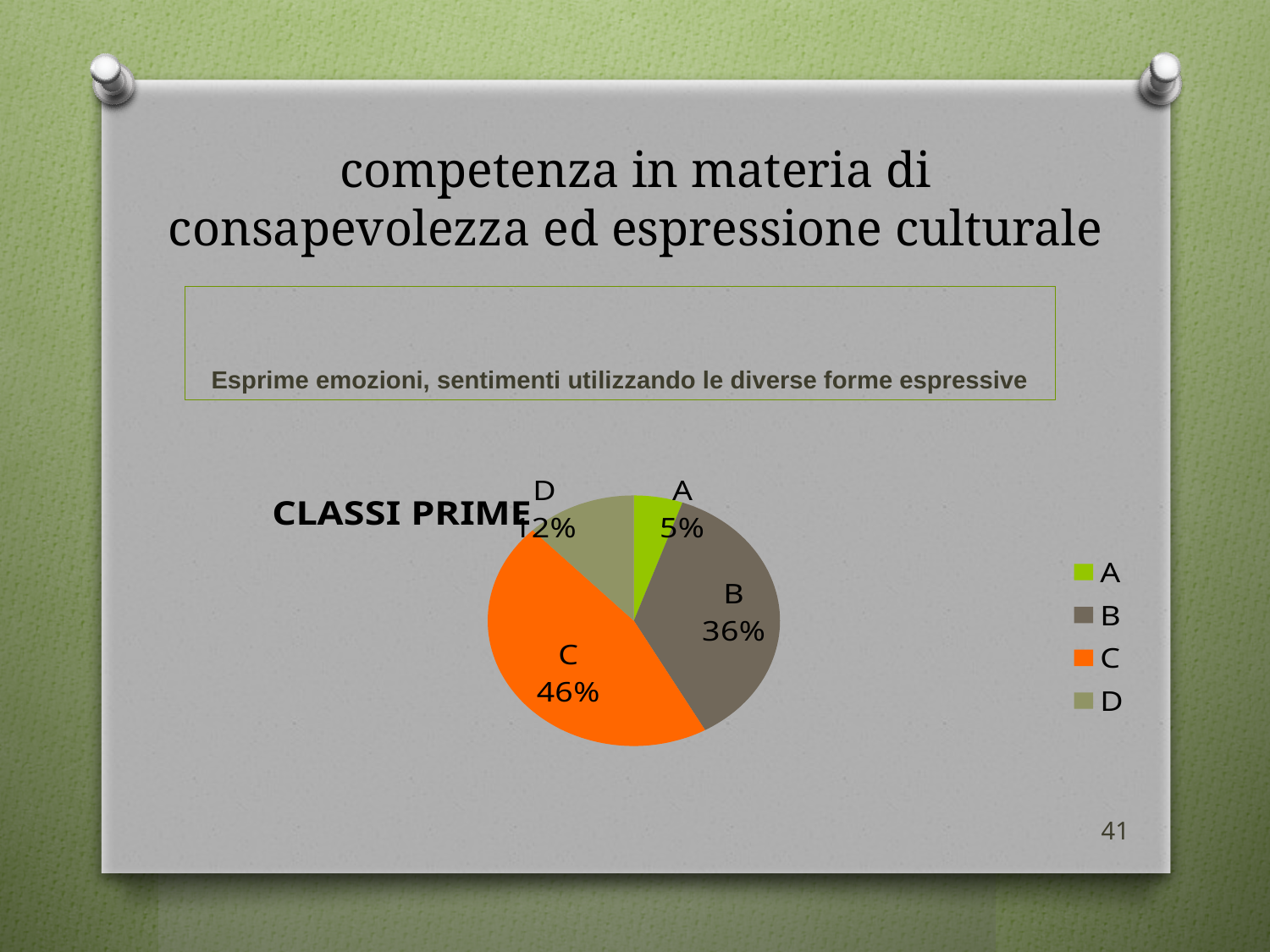
What is the difference in percentage points between C and B? 10 What colour is the slice for category C? orange Which category has the largest share of the pie? C What type of chart is shown on the slide? pie chart What percentage does slice A represent? 5% What is the title of the chart? CLASSI PRIME What percentage does slice B represent? 36% How many categories are shown in the pie chart? 4 What percentage does slice D represent? 12% Which is larger, the share for D or the share for A? D What percentage does slice C represent? 46% Which category has the smallest share of the pie? A